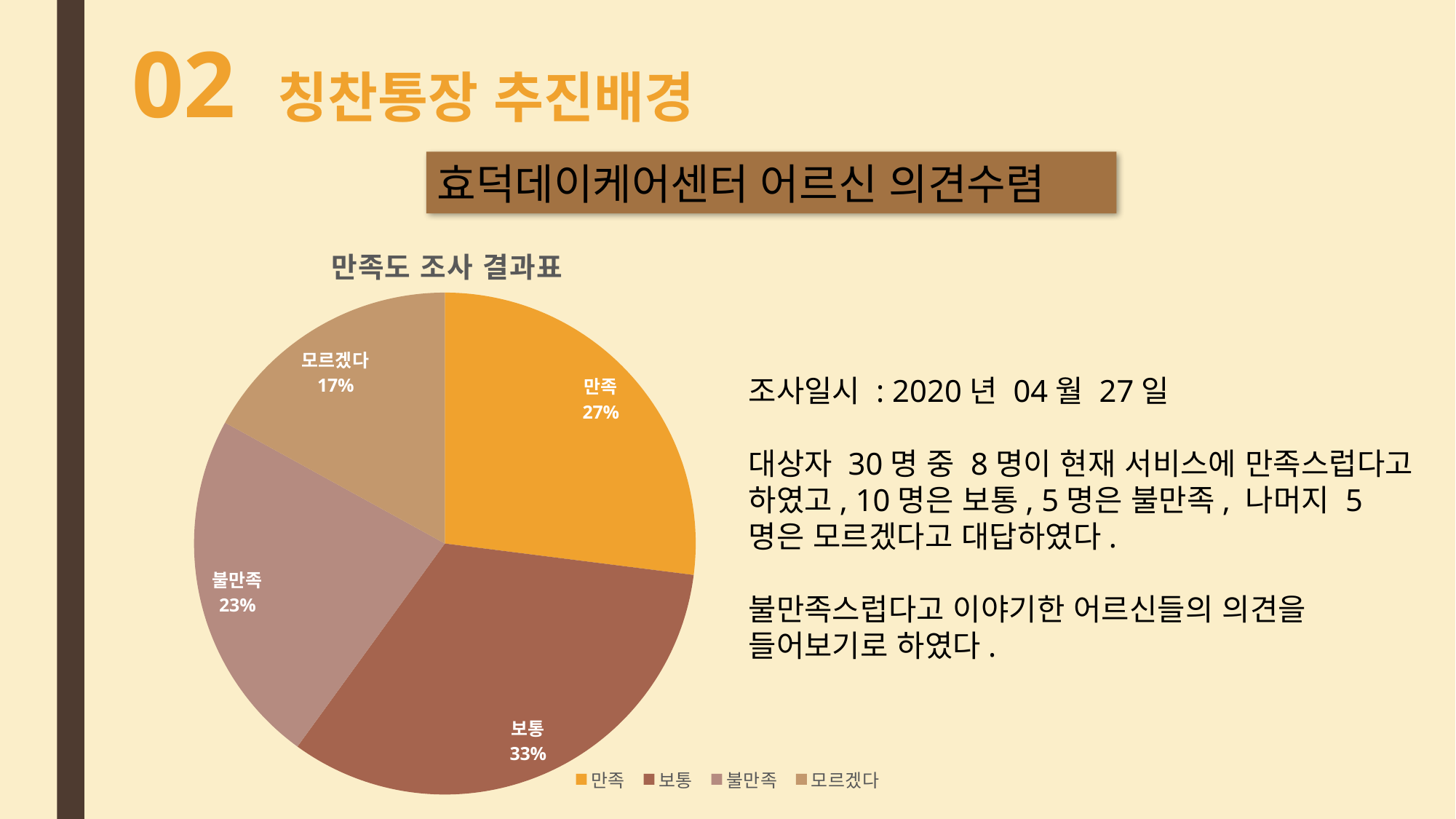
What share of the pie does 불만족 represent? 23% Which category has the smallest slice of the pie? 모르겠다 What is the difference in percentage points between 보통 and 만족? 6% Which category has the largest slice of the pie? 보통 How many categories does the pie chart have? 4 Which is larger, the share for 만족 or the share for 불만족? 만족 How many entries does the legend list? 4 What share of the pie does 보통 represent? 33% What is the title of the chart? 만족도 조사 결과표 What kind of chart is shown on the slide? pie chart What share of the pie does 만족 represent? 27%